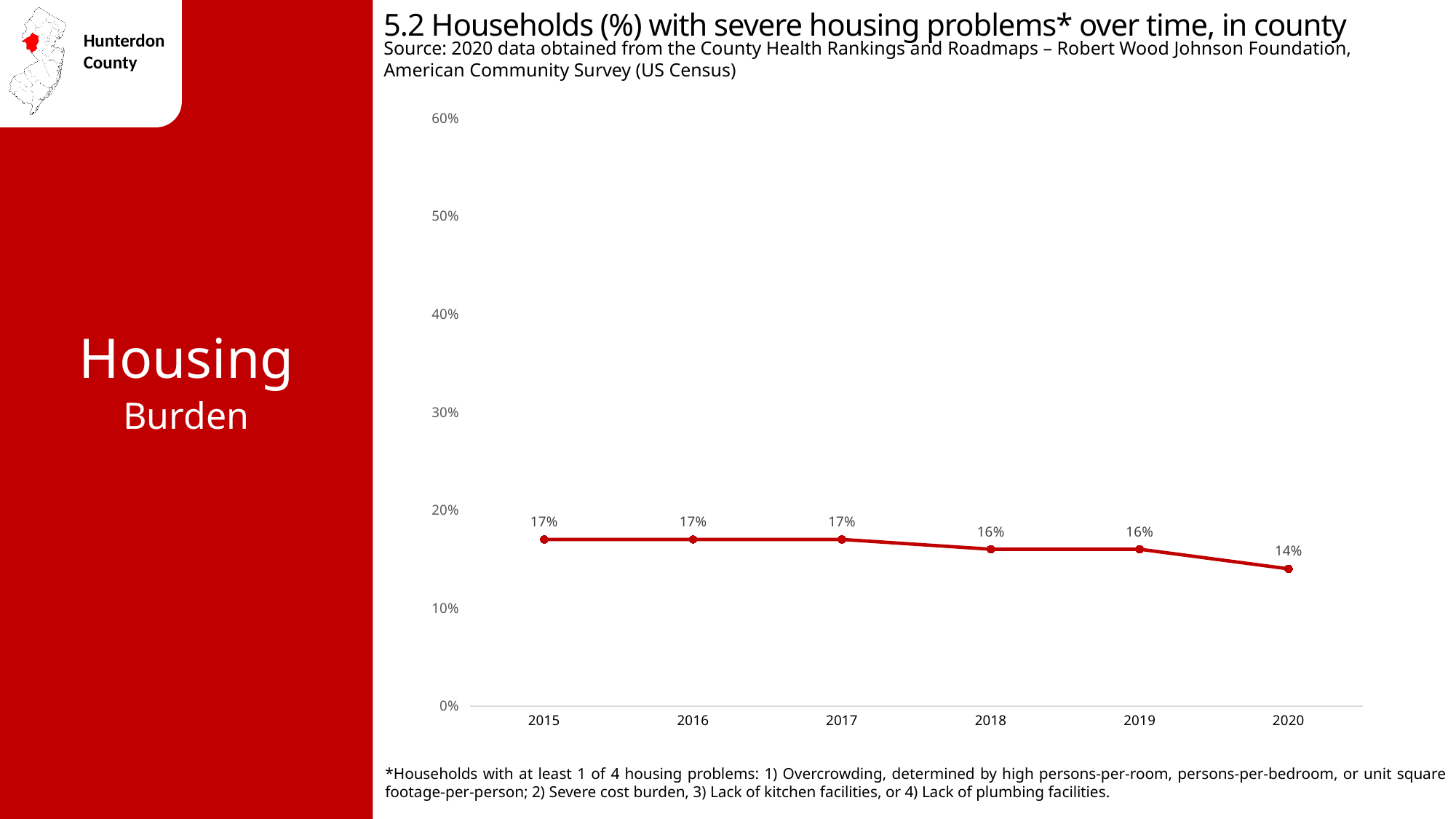
What kind of chart is shown on the slide? line chart Is the value for 2016 greater or less than 20%? less Which is larger, the value for 2019 or the value for 2020? 2019 What percentage of households had severe housing problems in 2018? 16% Do the values rise or fall from 2015 to 2020? fall Which year has the lowest percentage of households with severe housing problems? 2020 What is the difference between the 2017 value and the 2020 value? 3% What is the highest value shown on the y axis? 60% What is the title of the chart? 5.2 Households (%) with severe housing problems* over time, in county What percentage of households had severe housing problems in 2020? 14% How many years are plotted on the chart? 6 What percentage of households had severe housing problems in 2015? 17%